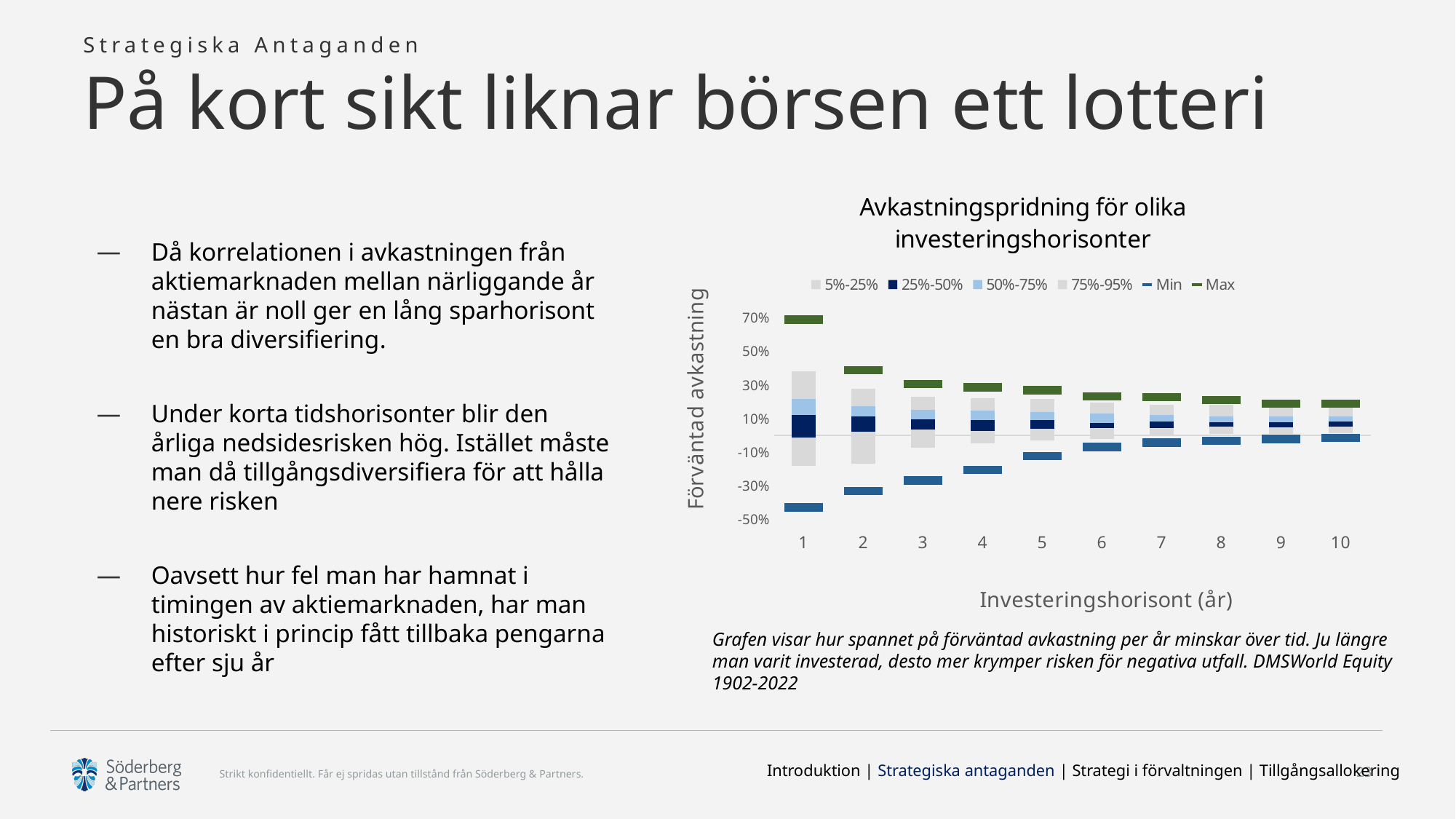
For which investment horizon is the Max value highest? 1 How many series does the chart legend list? 6 Is the Max value for investment horizon 10 greater or less than 30%? less Is the Min value for investment horizon 10 greater or less than -10%? greater Do the Max values rise or fall as the investment horizon increases from 1 to 10 years? fall How many investment horizons (categories) are shown on the x axis of the chart? 10 What is the label of the x axis of the chart? Investeringshorisont (år) What kind of chart is shown on the slide? Bar chart Is the Min value for investment horizon 1 greater or less than -30%? less What is the title of the chart on the slide? Avkastningspridning för olika investeringshorisonter For which investment horizon is the Min value lowest? 1